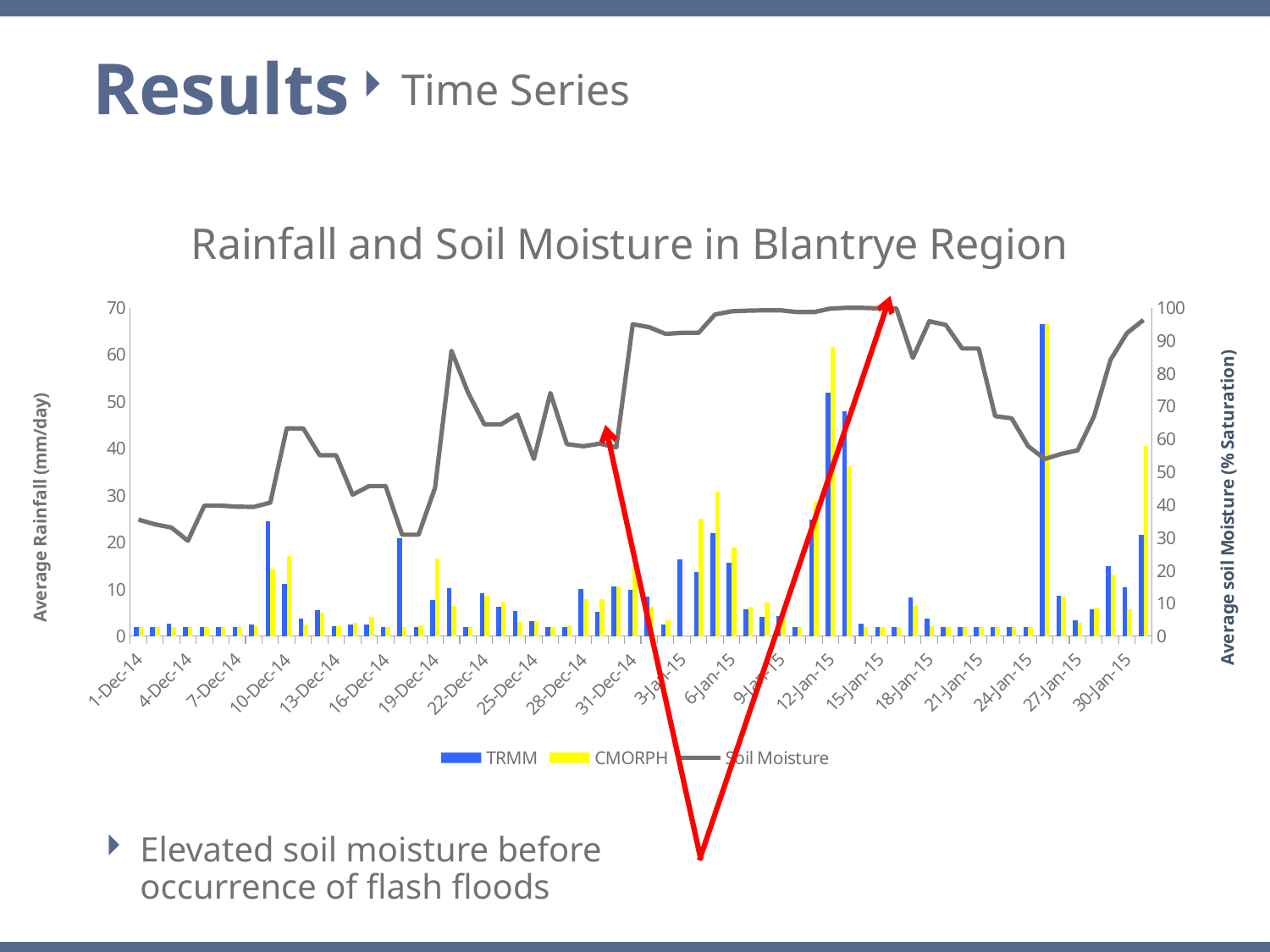
What is the title of the chart? Rainfall and Soil Moisture in Blantrye Region Which series is drawn as a line rather than bars? Soil Moisture On 10-Dec-14, which is larger, the TRMM value or the CMORPH value? CMORPH How many series does the chart's legend list? 3 On which date does the TRMM series reach its highest value? 25-Jan-15 On which labelled date is the Soil Moisture line at its lowest? 4-Dec-14 On 12-Jan-15, which is larger, the TRMM value or the CMORPH value? CMORPH What kind of chart is shown on the slide? Combined bar and line chart Is the CMORPH value on 12-Jan-15 greater or less than 50? greater Does the Soil Moisture line rise or fall overall from 1-Dec-14 to 15-Jan-15? rise Is the TRMM value on 10-Dec-14 greater or less than 20? less Is the Soil Moisture value on 12-Jan-15 greater or less than 90? greater